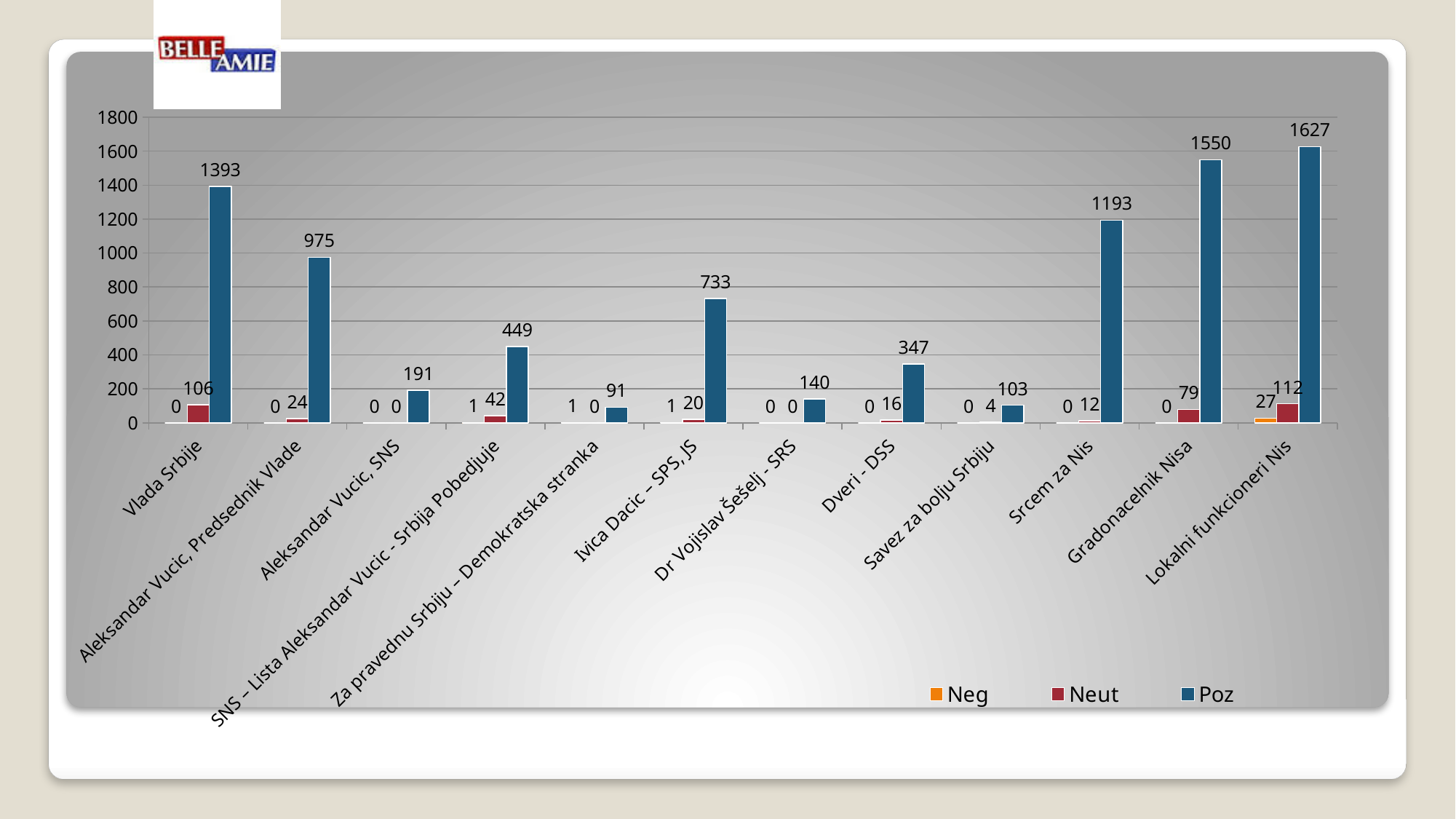
What is the Poz value for Vlada Srbije? 1393 What kind of chart is shown on the slide? Bar chart How many categories are shown on the x axis? 12 Which has a larger Poz value, Srcem za Nis or Aleksandar Vucic, Predsednik Vlade? Srcem za Nis What is the Neut value for Gradonacelnik Nisa? 79 What is the total of the Neg, Neut and Poz values for Dveri - DSS? 363 What is the Neg value for Lokalni funkcioneri Nis? 27 Which category has the highest Poz value? Lokalni funkcioneri Nis How many series does the legend list? 3 Which category has the lowest Poz value? Za pravednu Srbiju – Demokratska stranka What is the Poz value for Ivica Dacic – SPS, JS? 733 What is the difference between the Poz values for Lokalni funkcioneri Nis and Gradonacelnik Nisa? 77